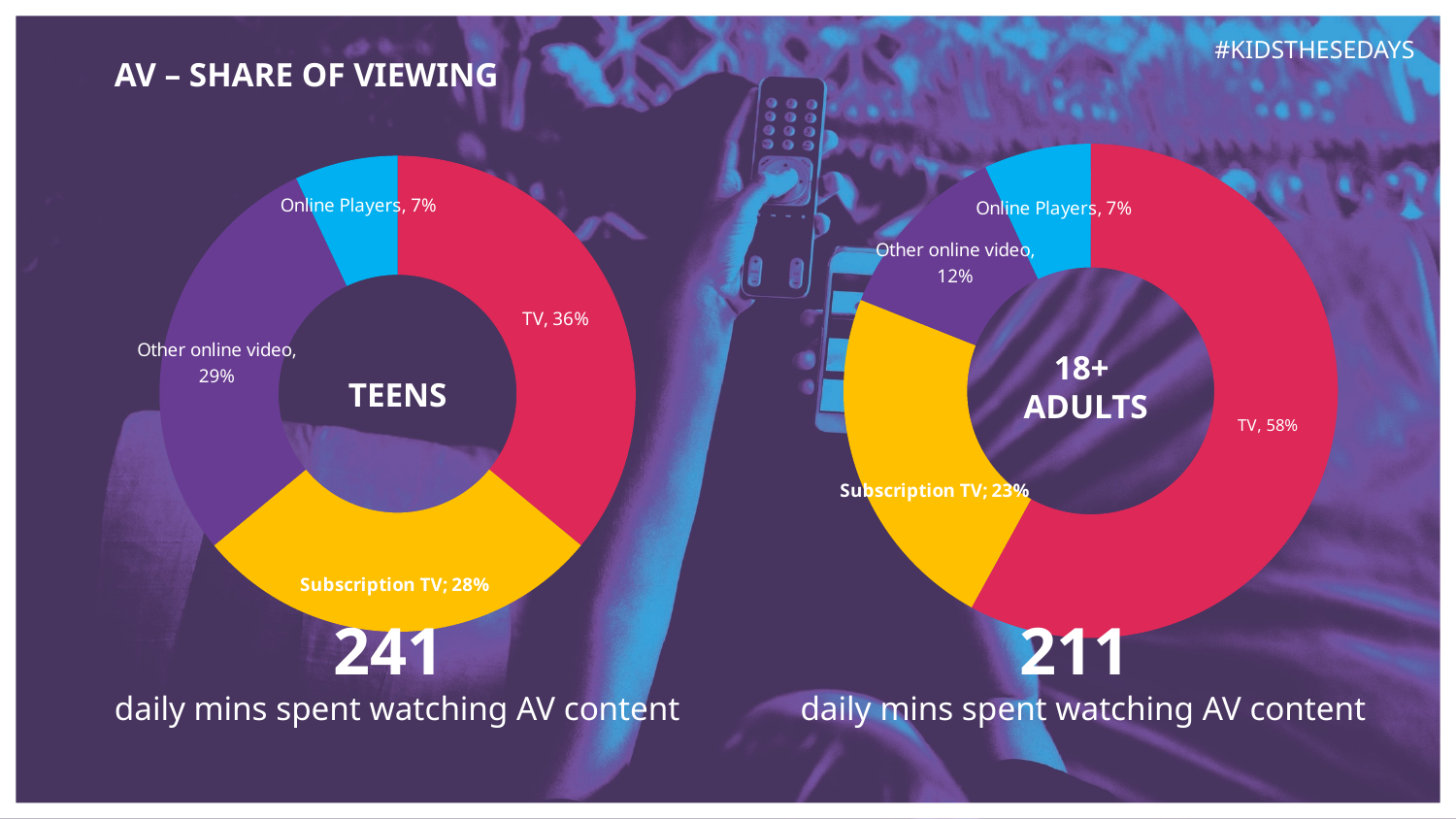
In the TEENS chart, what is the combined share of Subscription TV and Other online video? 57% In the TEENS chart, what share of viewing is Other online video? 29% Which is larger: the Other online video share for TEENS or for 18+ ADULTS? TEENS How many categories does the TEENS chart show? 4 In the 18+ ADULTS chart, what share of viewing is Subscription TV? 23% In the TEENS chart, what share of viewing is TV? 36% In the TEENS chart, which category has the largest share? TV In the 18+ ADULTS chart, which category has the smallest share? Online Players What kind of chart is the 18+ ADULTS chart? Doughnut (pie) chart What is the difference between the TV share in the 18+ ADULTS chart and the TV share in the TEENS chart? 22 percentage points What is the title of the slide containing the two charts? AV – SHARE OF VIEWING In the 18+ ADULTS chart, what share of viewing is TV? 58%